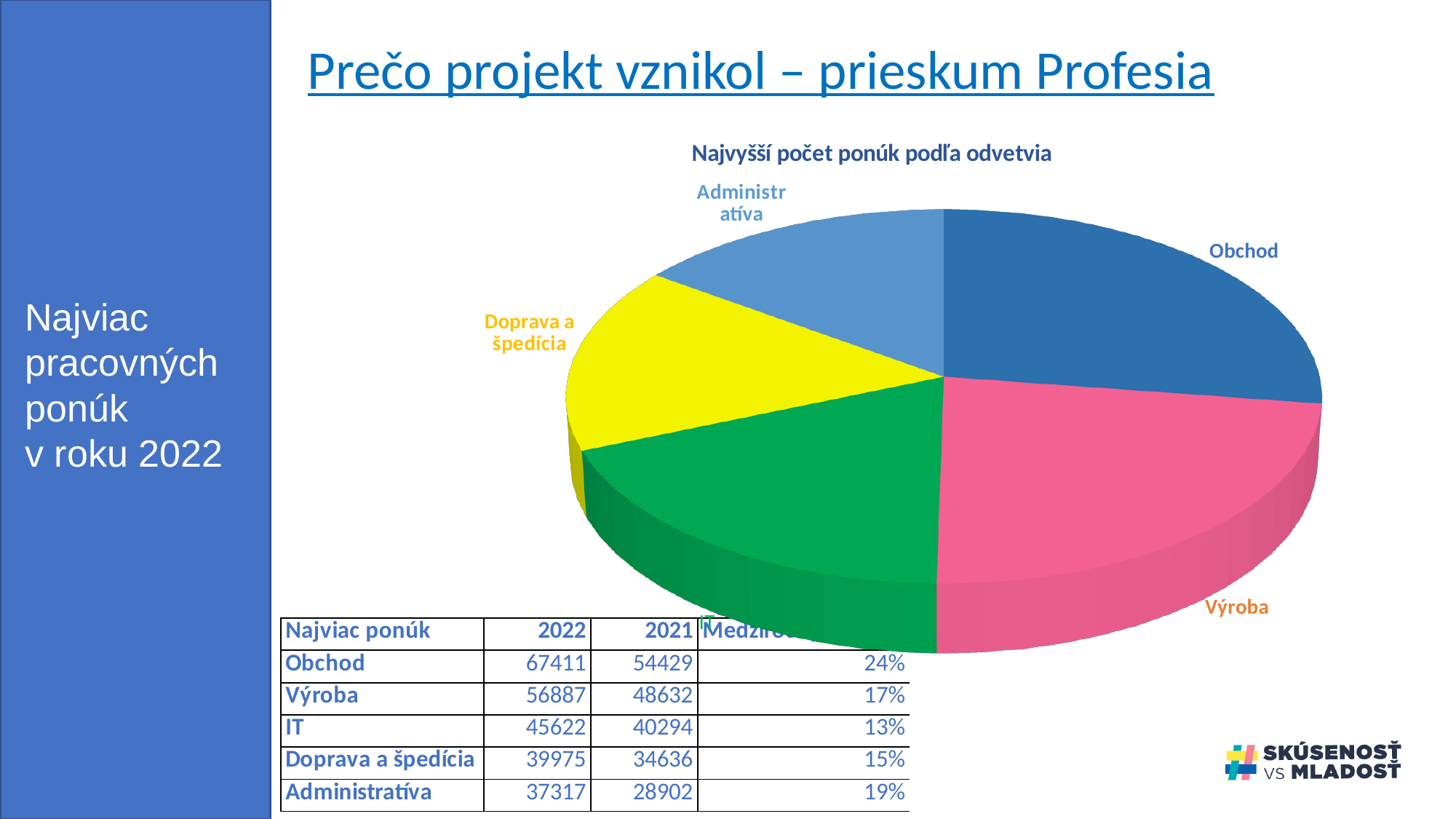
How many slices does the pie chart have? 5 In the pie chart, which slice is larger: Obchod or Administratíva? Obchod In the pie chart, which slice is larger: IT or Administratíva? IT What type of chart is shown on the slide? pie chart Which slice of the pie chart is coloured yellow? Doprava a špedícia According to the table below the chart, what is the 2022 value for Obchod? 67411 According to the table below the chart, what is the 2021 value for IT? 40294 According to the table below the chart, what is the 2022 value for Administratíva? 37317 According to the table below the chart, which category has the highest 2022 value? Obchod According to the table below the chart, what is the difference between the 2022 and 2021 values for Výroba? 8255 In the pie chart, which slice is larger: Výroba or Doprava a špedícia? Výroba What is the title of the pie chart? Najvyšší počet ponúk podľa odvetvia